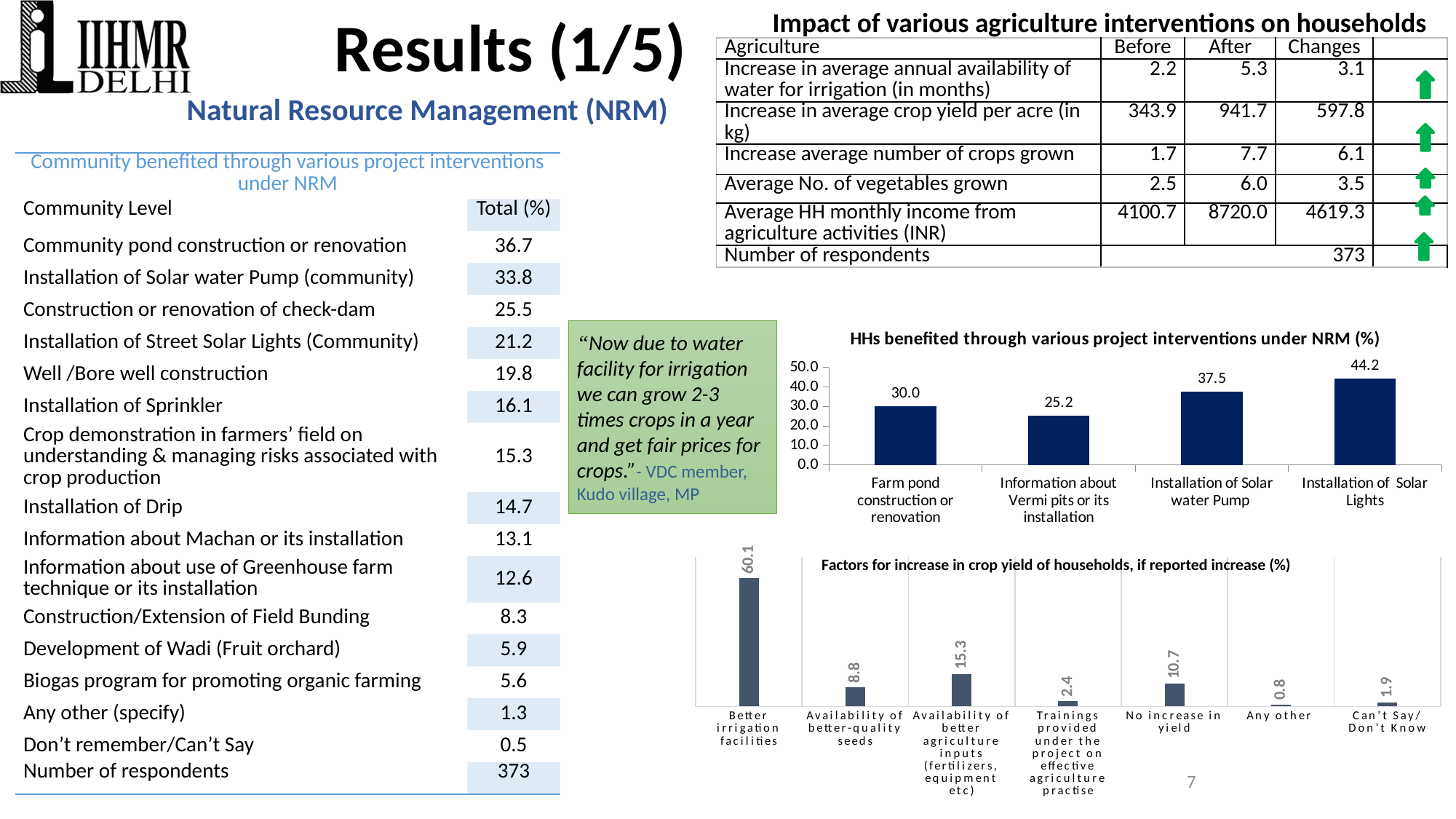
In the chart titled "Factors for increase in crop yield of households, if reported increase (%)", what is the value for Better irrigation facilities? 60.1 In the chart titled "Factors for increase in crop yield of households, if reported increase (%)", what is the value for No increase in yield? 10.7 What kind of chart is "HHs benefited through various project interventions under NRM (%)"? Bar chart In the chart titled "Factors for increase in crop yield of households, if reported increase (%)", which is larger: Availability of better-quality seeds or Availability of better agriculture inputs (fertilizers, equipment etc)? Availability of better agriculture inputs (fertilizers, equipment etc) In the chart titled "Factors for increase in crop yield of households, if reported increase (%)", which category has the lowest value? Any other In the chart titled "Factors for increase in crop yield of households, if reported increase (%)", how many categories are plotted? 7 In the chart titled "HHs benefited through various project interventions under NRM (%)", which category has the lowest value? Information about Vermi pits or its installation In the chart titled "HHs benefited through various project interventions under NRM (%)", how many categories are plotted? 4 In the chart titled "HHs benefited through various project interventions under NRM (%)", which category has the highest value? Installation of Solar Lights In the chart titled "HHs benefited through various project interventions under NRM (%)", what is the value for Installation of Solar water Pump? 37.5 In the chart titled "HHs benefited through various project interventions under NRM (%)", what is the difference between Installation of Solar Lights and Farm pond construction or renovation? 14.2 In the chart titled "Factors for increase in crop yield of households, if reported increase (%)", what is the difference between Better irrigation facilities and Availability of better agriculture inputs (fertilizers, equipment etc)? 44.8